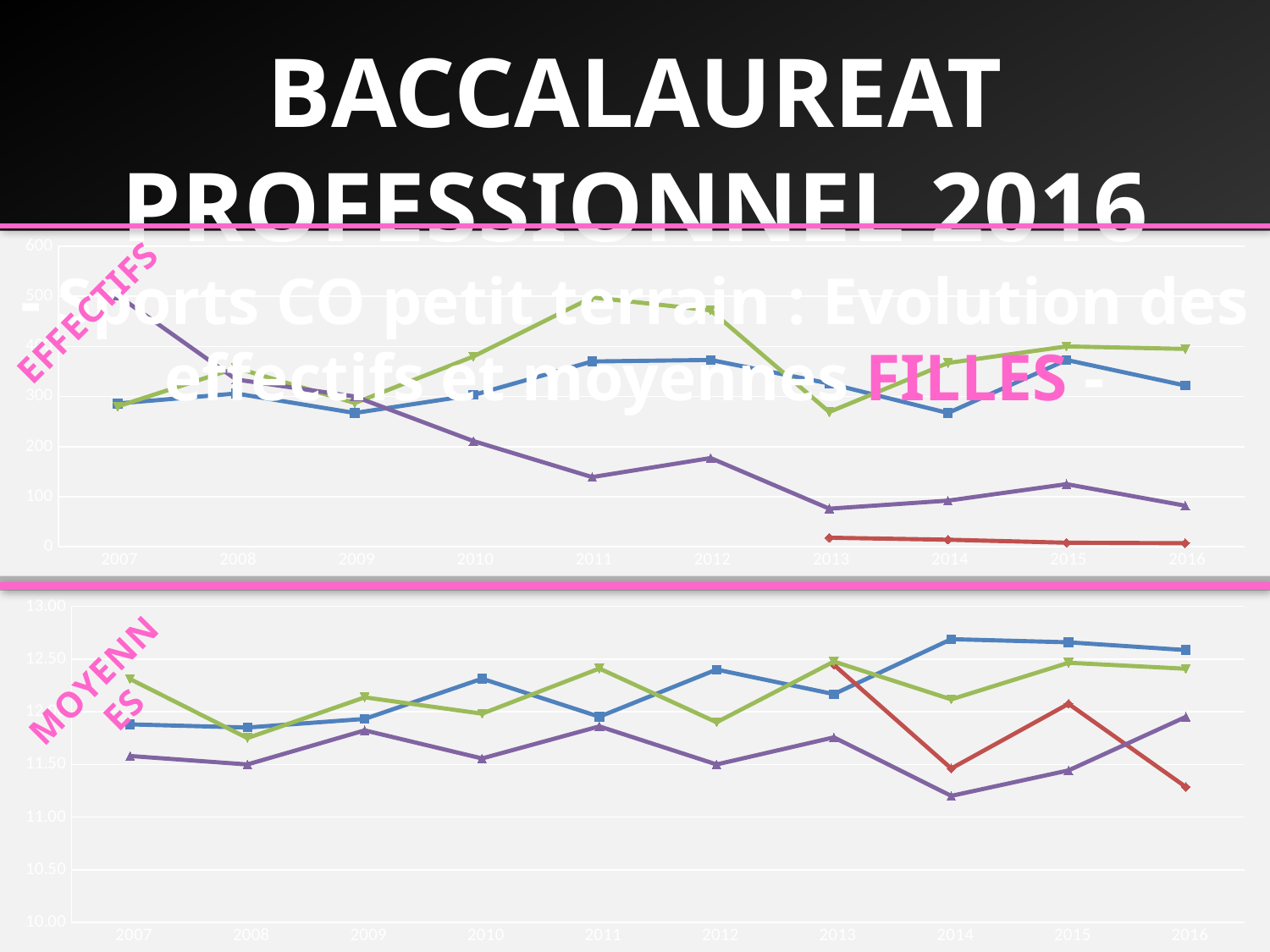
In the top chart (EFFECTIFS), in which year does the red line first appear? 2013 In the top chart (EFFECTIFS), does the purple line overall rise or fall from 2007 to 2016? Fall In the bottom chart (MOYENNES), is the value of the blue line in 2014 greater or less than 12.50? greater In the top chart (EFFECTIFS), is the value of the purple line in 2016 greater or less than 100? less In the bottom chart (MOYENNES), which is larger in 2014, the blue line or the purple line? The blue line In the top chart (EFFECTIFS), is the value of the purple line in 2007 greater or less than 400? greater In the top chart (EFFECTIFS), in which year does the purple line reach its highest value? 2007 In the top chart (EFFECTIFS), how many years are shown on the x axis? 10 What kind of chart is the top chart labelled EFFECTIFS? Line chart What kind of chart is the bottom chart labelled MOYENNES? Line chart In the bottom chart (MOYENNES), in which year does the purple line reach its lowest value? 2014